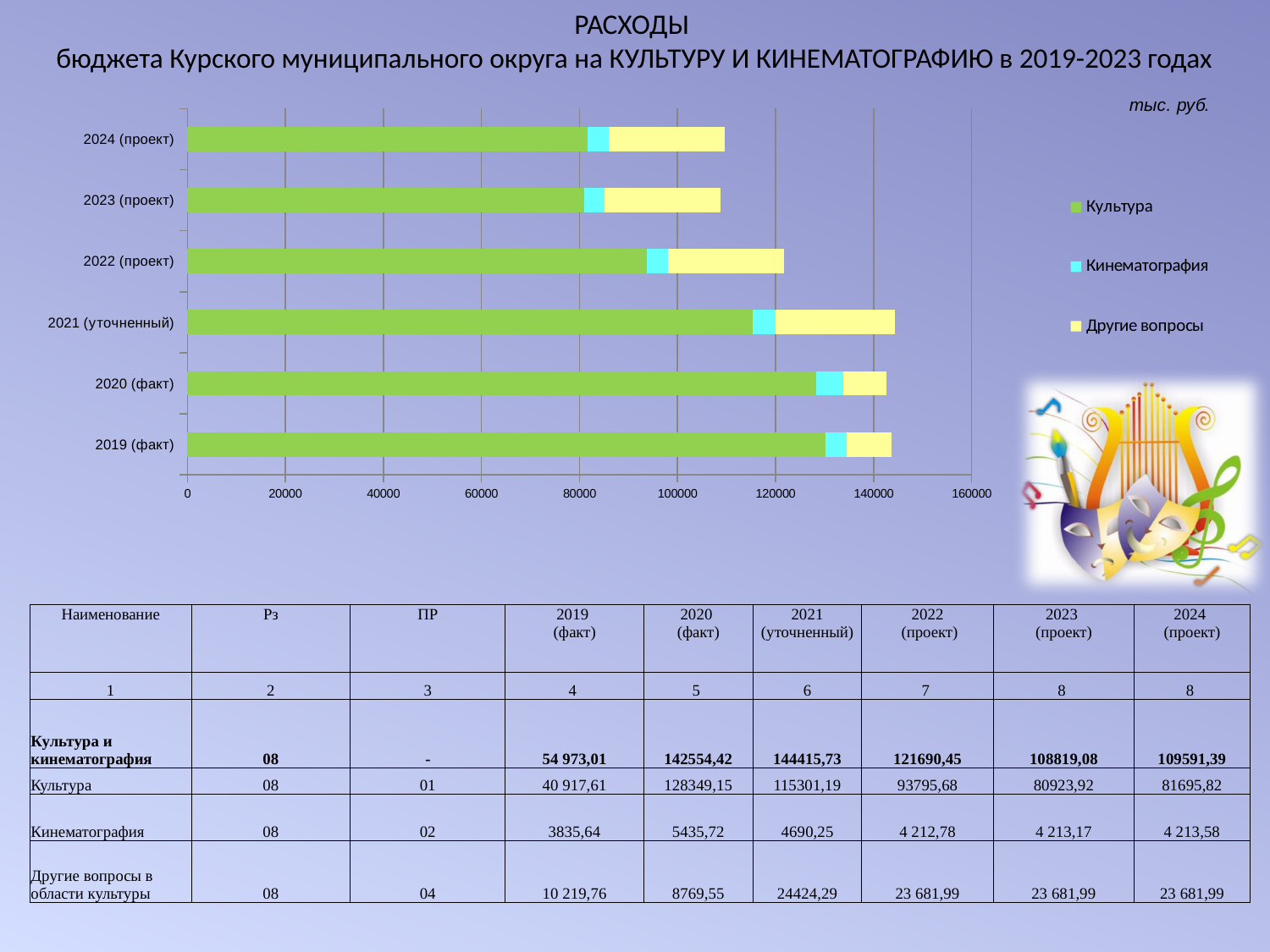
According to the table on the slide, what is the total for Культура и кинематография in 2022 (проект)? 121690,45 Which is larger, the Культура value for 2021 (уточненный) or for 2022 (проект)? 2021 (уточненный) Does the Культура value rise or fall from 2020 (факт) to 2023 (проект)? fall According to the table on the slide, what is the Культура value for 2021 (уточненный)? 115301,19 What kind of chart is shown on the slide? stacked bar chart Which colour represents Культура in the chart legend? green Is the total bar for 2023 (проект) greater or less than 100000? greater Is the Культура value for 2020 (факт) greater or less than 120000? greater How many series does the chart legend list? 3 Is the Культура value for 2024 (проект) greater or less than 100000? less How many year categories are plotted on the chart? 6